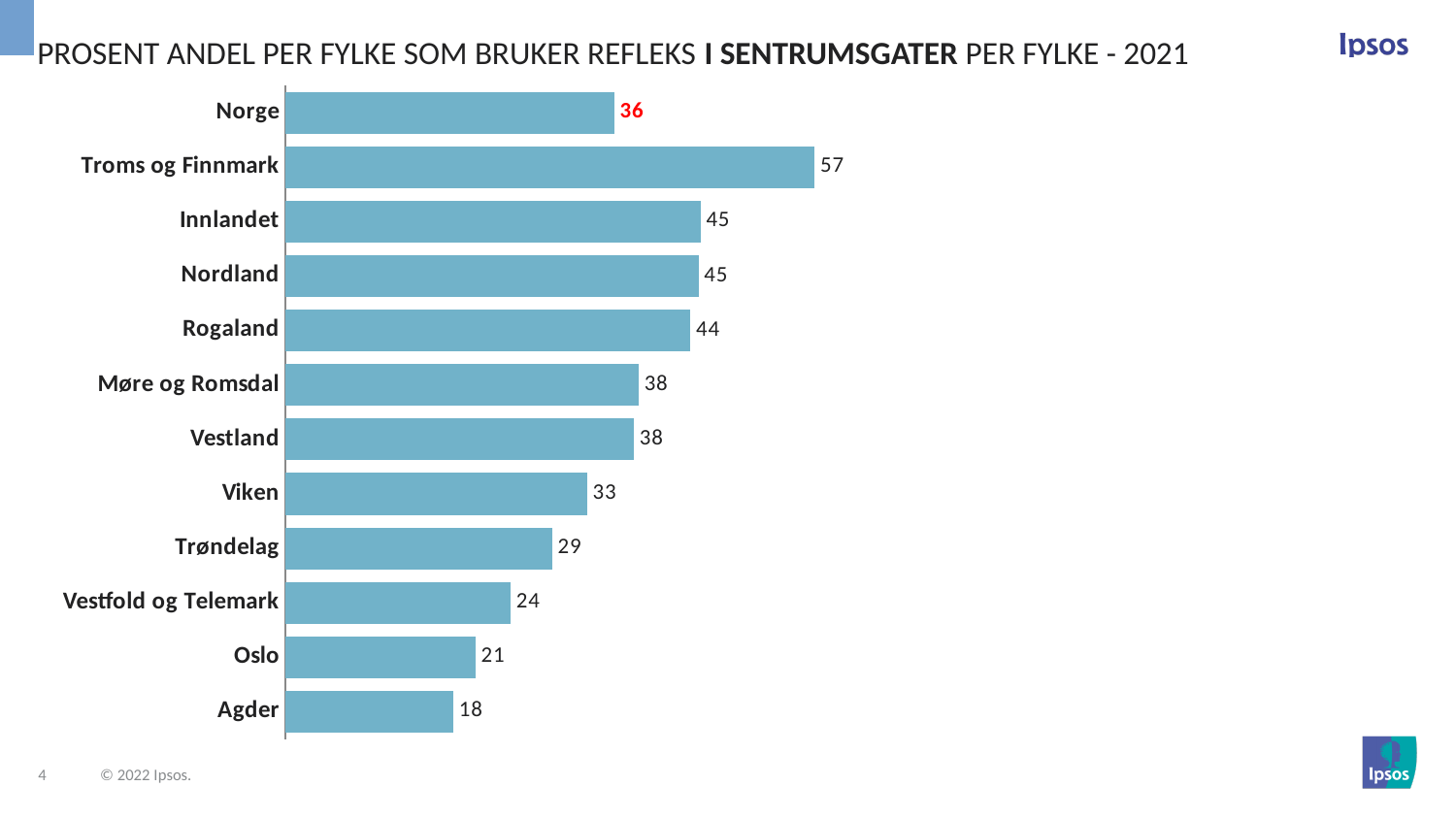
What is the difference between the values for Rogaland and Viken? 11 What is the value for Oslo? 21 How many categories are shown in the chart? 12 What kind of chart is shown on the slide? Bar chart What is the difference between the values for Troms og Finnmark and Agder? 39 Which is larger, the value for Innlandet or the value for Møre og Romsdal? Innlandet Which category has the lowest value? Agder Which is larger, the value for Trøndelag or the value for Vestfold og Telemark? Trøndelag Which category's data label is shown in red? Norge What is the value for Norge? 36 Which category has the highest value? Troms og Finnmark What is the value for Troms og Finnmark? 57